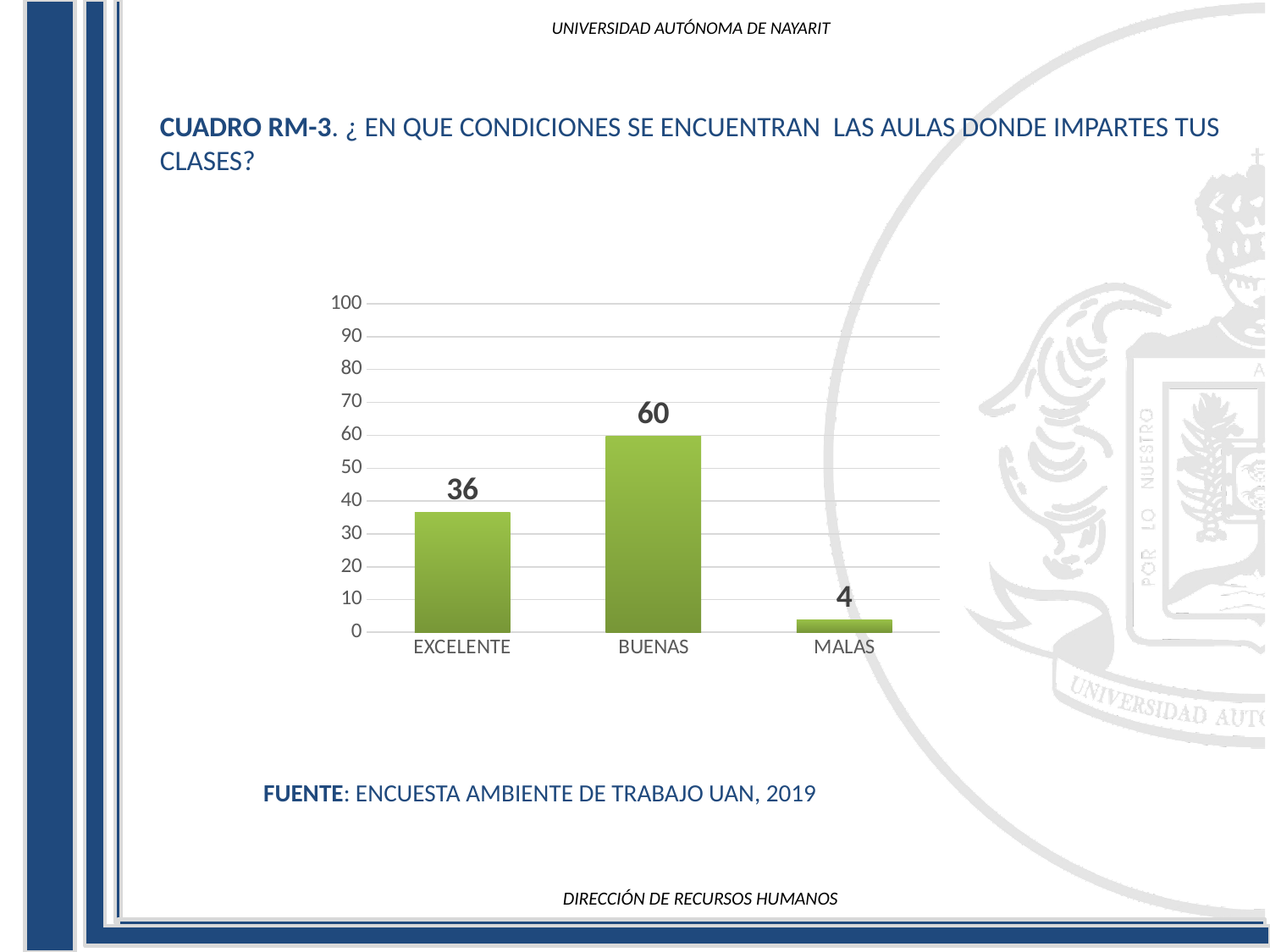
What is the difference between the values for EXCELENTE and MALAS? 32 What is the value for BUENAS? 60 How many categories are shown on the x axis? 3 What is the source cited below the chart? ENCUESTA AMBIENTE DE TRABAJO UAN, 2019 Which is larger, the value for EXCELENTE or the value for MALAS? EXCELENTE Is the value for BUENAS greater or less than 50? greater What is the value for EXCELENTE? 36 What is the difference between the values for BUENAS and EXCELENTE? 24 What is the value for MALAS? 4 Which category has the highest value? BUENAS Which category has the lowest value? MALAS What kind of chart is shown on the slide? bar chart